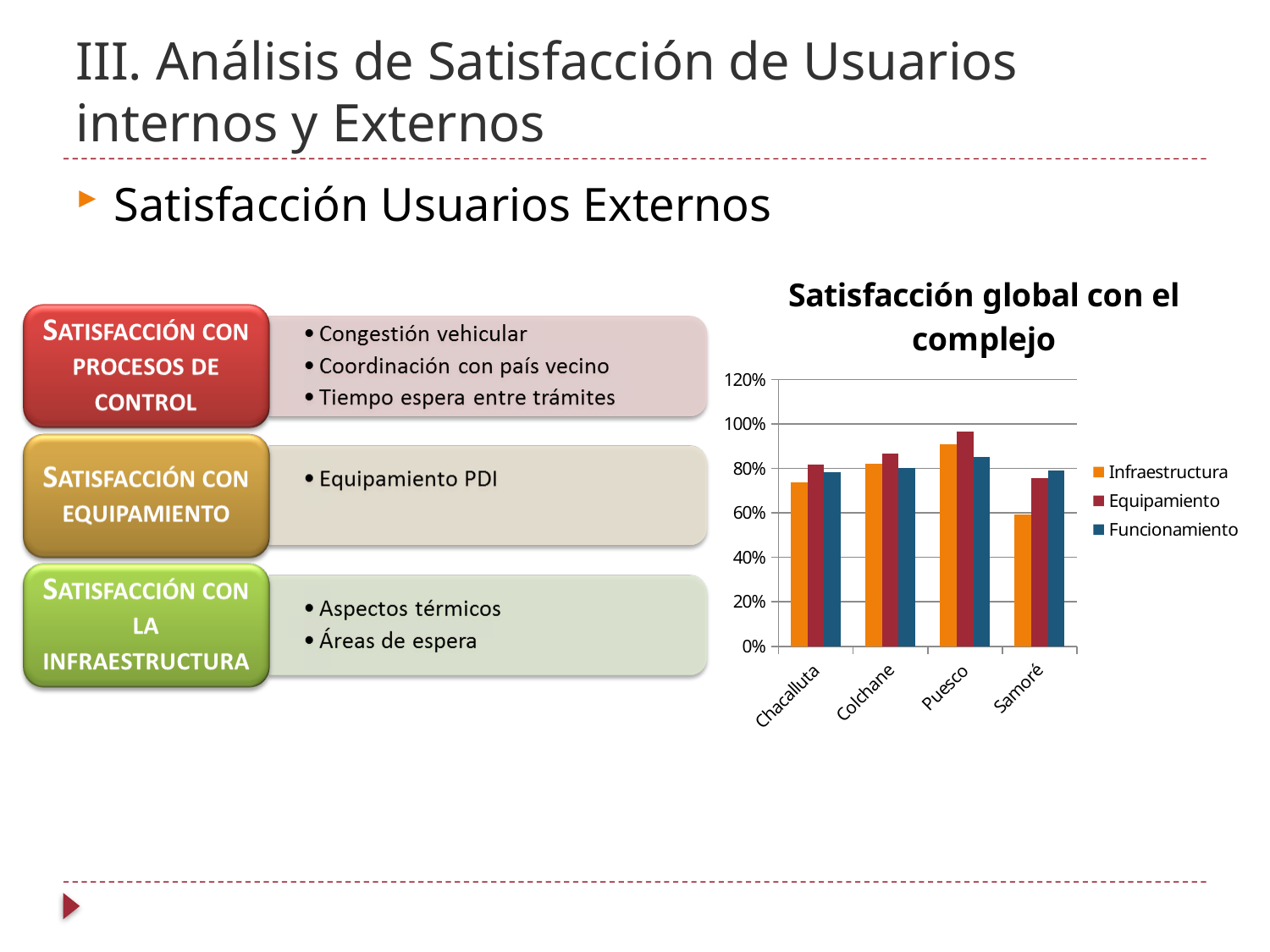
In the 'Satisfacción global con el complejo' chart, which category has the highest Equipamiento value? Puesco In the 'Satisfacción global con el complejo' chart, is the Infraestructura value for Puesco greater or less than 80%? greater In the 'Satisfacción global con el complejo' chart, which is larger for Samoré: Infraestructura or Equipamiento? Equipamiento How many categories are shown on the x axis of the 'Satisfacción global con el complejo' chart? 4 What kind of chart is 'Satisfacción global con el complejo'? bar chart In the 'Satisfacción global con el complejo' chart, is the Infraestructura value for Samoré greater or less than 80%? less In the 'Satisfacción global con el complejo' chart, is the Equipamiento value for Puesco greater or less than 80%? greater How many series does the legend of the 'Satisfacción global con el complejo' chart list? 3 In the 'Satisfacción global con el complejo' chart, which is larger: the Infraestructura value for Puesco or for Samoré? Puesco What is the title of the chart on the slide? Satisfacción global con el complejo In the 'Satisfacción global con el complejo' chart, which category has the lowest Infraestructura value? Samoré